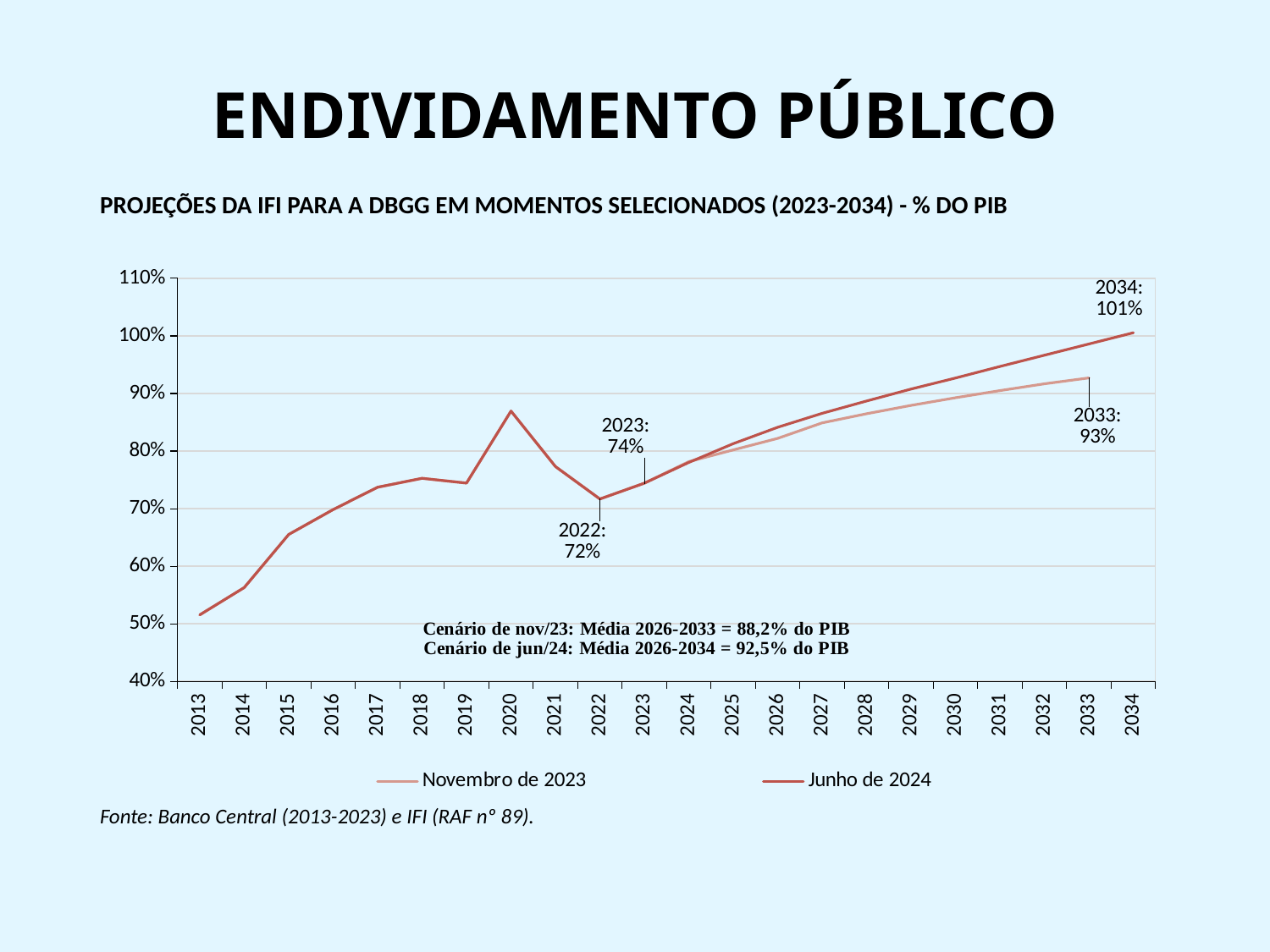
What value is labelled for 2022? 72% What value does the Junho de 2024 series reach in 2034? 101% What value does the Novembro de 2023 series reach in 2033? 93% What kind of chart is shown on the slide? line chart Is the value for 2020 greater or less than 80%? greater By how many percentage points does the labelled 2023 value exceed the labelled 2022 value? 2 percentage points Is the value for 2013 greater or less than 60%? less According to the annotation, what is the average for 2026-2034 in the jun/24 scenario? 92,5% do PIB How many series does the legend list? 2 What value is labelled for 2023? 74% How many years are shown on the x axis? 22 Which year has the lowest value on the chart? 2013